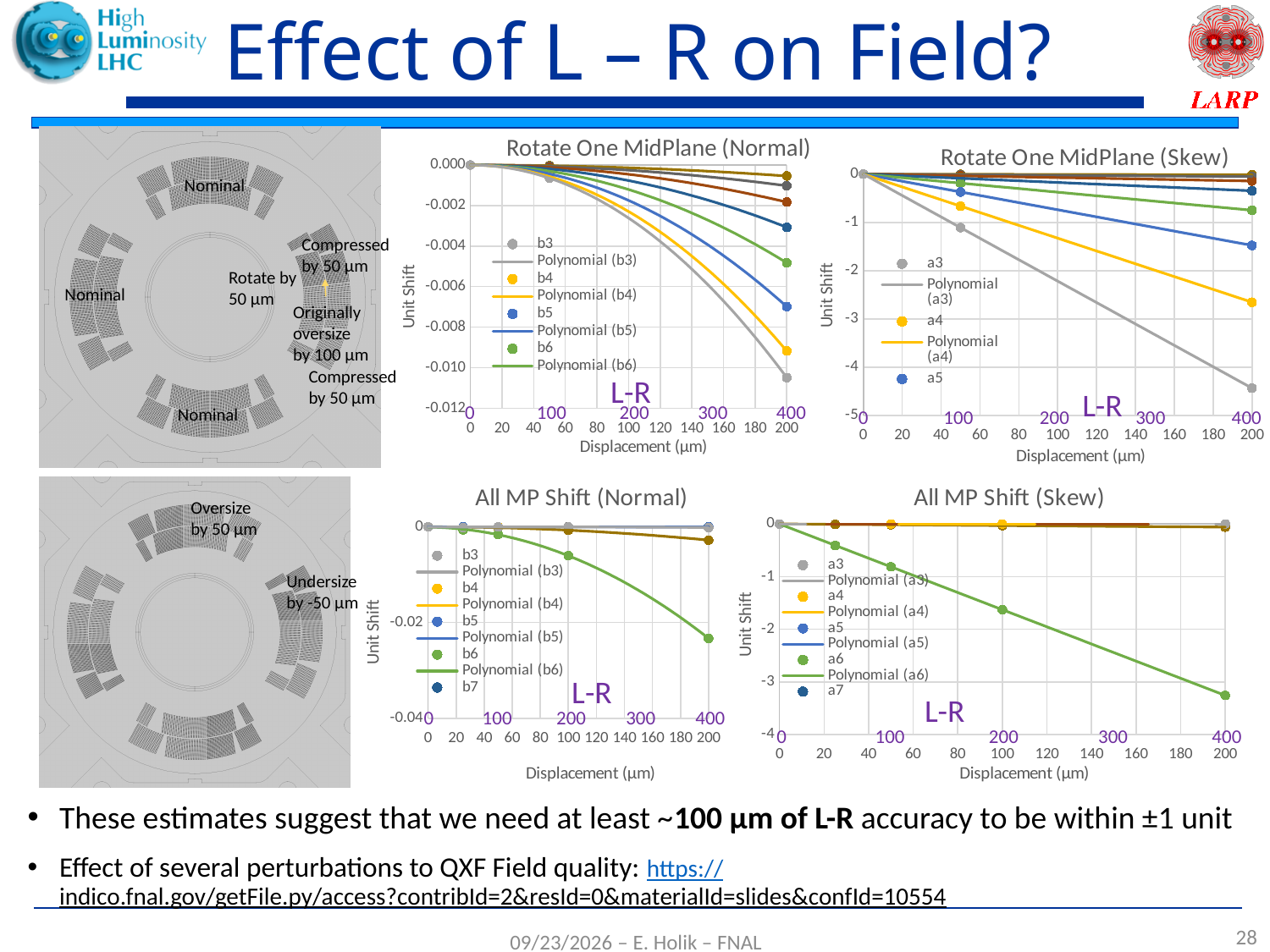
In the "Rotate One MidPlane (Normal)" chart, is the value of b3 at 200 µm displacement greater or less than -0.008? less In the "Rotate One MidPlane (Normal)" chart, how many data series (excluding the polynomial fit lines) does the legend list? 4 In the "Rotate One MidPlane (Normal)" chart, which series has the lowest value at 200 µm displacement? b3 In the "Rotate One MidPlane (Skew)" chart, which series has the lowest value at 200 µm displacement? a3 In the "Rotate One MidPlane (Skew)" chart, which is larger at 200 µm displacement, a3 or a4? a4 In the "All MP Shift (Skew)" chart, is the value of a6 at 200 µm displacement greater or less than -3? less In the "Rotate One MidPlane (Normal)" chart, do the b3 values rise or fall as displacement increases? fall What kind of chart is "Rotate One MidPlane (Normal)"? Scatter chart with polynomial trend lines In the "Rotate One MidPlane (Skew)" chart, is the value of a3 at 200 µm displacement greater or less than -4? less In the "All MP Shift (Skew)" chart, which series has the lowest value at 200 µm displacement? a6 What is the x-axis label of the "All MP Shift (Normal)" chart? Displacement (µm)